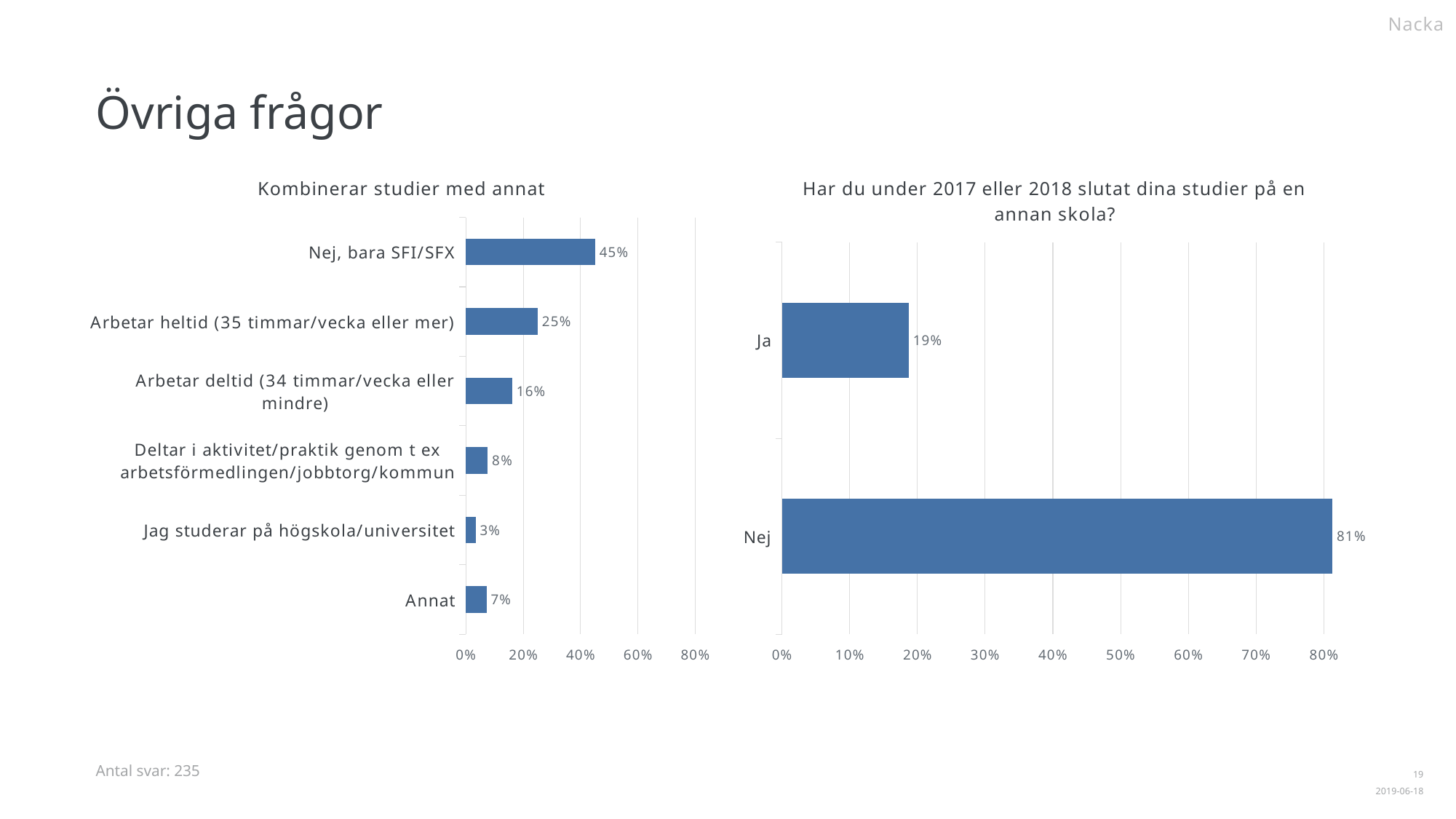
How many categories are shown in the chart 'Kombinerar studier med annat'? 6 In the chart 'Har du under 2017 eller 2018 slutat dina studier på en annan skola?', what is the difference between 'Nej' and 'Ja'? 62% In the chart 'Kombinerar studier med annat', which is larger: 'Annat' or 'Deltar i aktivitet/praktik genom t ex arbetsförmedlingen/jobbtorg/kommun'? Deltar i aktivitet/praktik genom t ex arbetsförmedlingen/jobbtorg/kommun In the chart 'Har du under 2017 eller 2018 slutat dina studier på en annan skola?', what is the value for 'Nej'? 81% In the chart 'Kombinerar studier med annat', is the value for 'Nej, bara SFI/SFX' greater or less than 40%? greater In the chart 'Kombinerar studier med annat', what is the value for 'Arbetar heltid (35 timmar/vecka eller mer)'? 25% In the chart 'Kombinerar studier med annat', which category has the lowest value? Jag studerar på högskola/universitet In the chart 'Har du under 2017 eller 2018 slutat dina studier på en annan skola?', what is the value for 'Ja'? 19% In the chart 'Kombinerar studier med annat', what is the difference between 'Arbetar heltid (35 timmar/vecka eller mer)' and 'Arbetar deltid (34 timmar/vecka eller mindre)'? 9% In the chart 'Kombinerar studier med annat', which category has the highest value? Nej, bara SFI/SFX What kind of chart is the chart on the right of the slide? Bar chart In the chart 'Kombinerar studier med annat', what is the value for 'Nej, bara SFI/SFX'? 45%